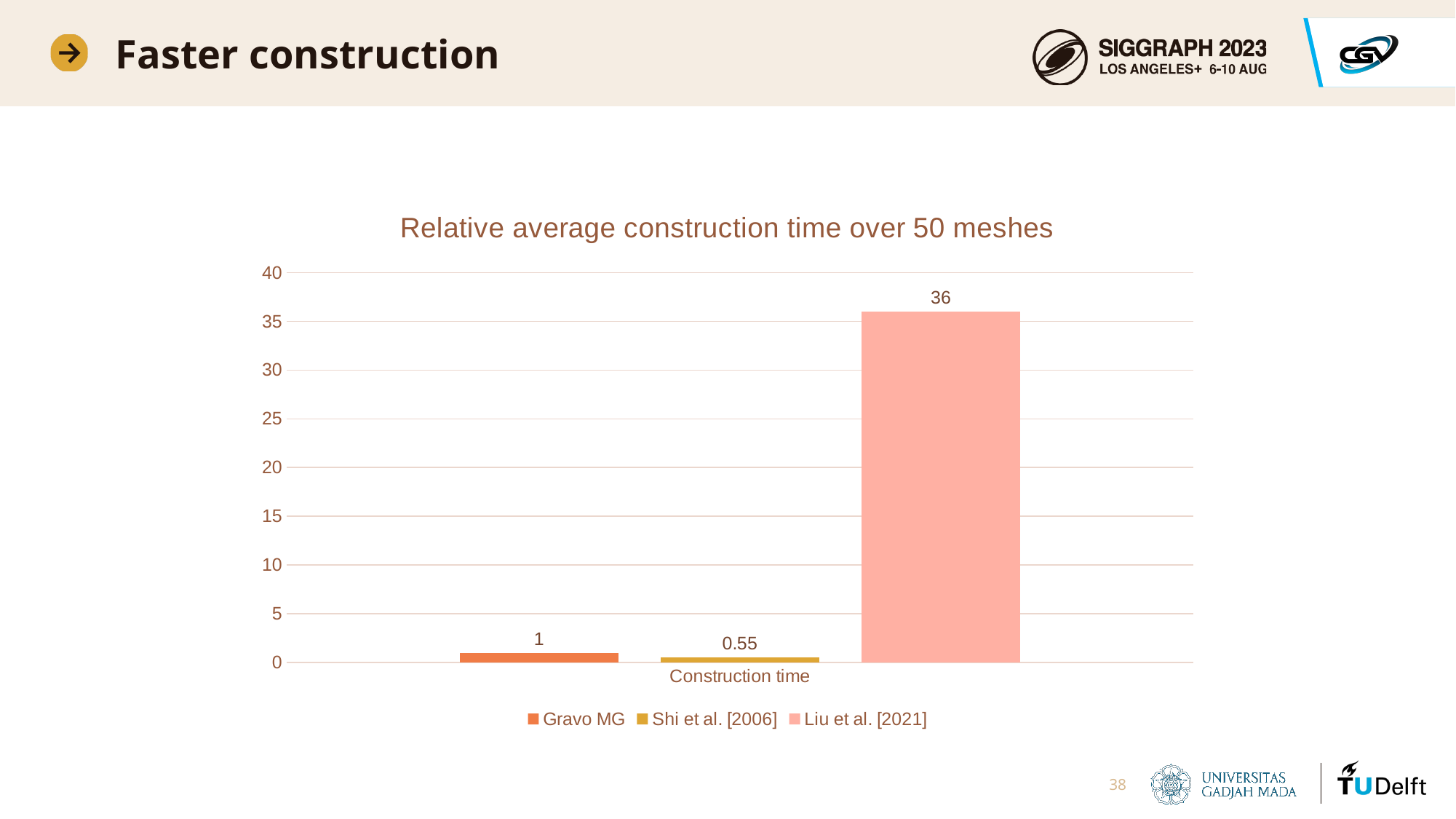
Which is larger, the value for Gravo MG or the value for Shi et al. [2006]? Gravo MG What kind of chart is shown on the slide? bar chart What is the value for Liu et al. [2021] in the chart? 36 What is the difference between the values for Gravo MG and Shi et al. [2006]? 0.45 What is the title of the chart? Relative average construction time over 50 meshes What is the value for Shi et al. [2006] in the chart? 0.55 Is the value for Liu et al. [2021] greater or less than 30? greater Which series has the highest relative average construction time? Liu et al. [2021] What is the value for Gravo MG in the chart? 1 What is the difference between the values for Liu et al. [2021] and Gravo MG? 35 Which series has the lowest relative average construction time? Shi et al. [2006] How many series does the legend list? 3